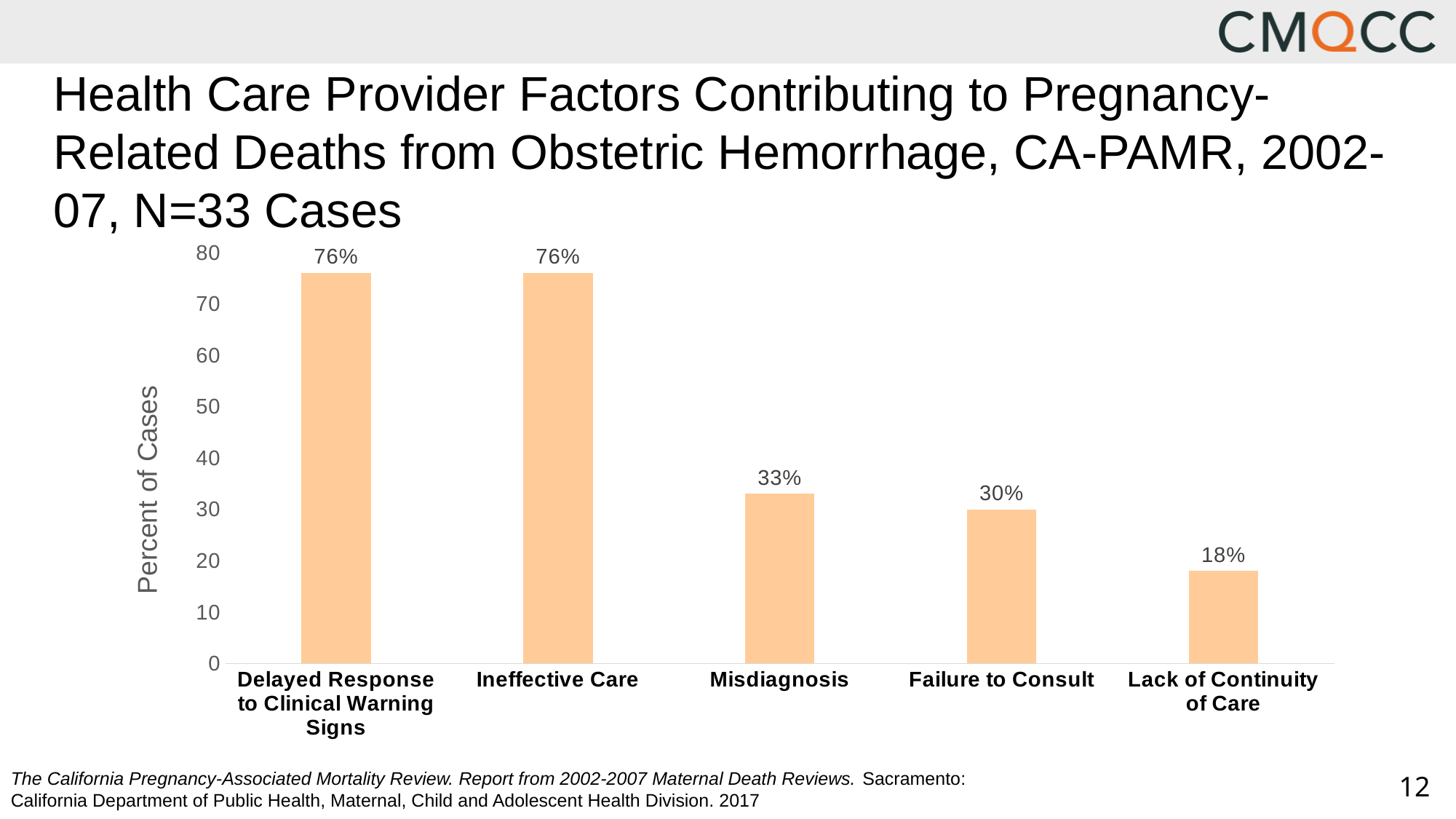
What percent of cases is shown for Misdiagnosis? 33% Is the value for Failure to Consult greater or less than 40? less What is the value for Failure to Consult? 30% What is the difference between the values for Delayed Response to Clinical Warning Signs and Failure to Consult? 46% How many categories are shown on the x axis? 5 What is the value for Ineffective Care? 76% What is the difference between the values for Misdiagnosis and Lack of Continuity of Care? 15% Which is larger, the value for Misdiagnosis or the value for Lack of Continuity of Care? Misdiagnosis Which category has the lowest percent of cases? Lack of Continuity of Care What kind of chart is shown on the slide? Bar chart What is the label of the vertical axis? Percent of Cases What percent of cases is shown for Lack of Continuity of Care? 18%